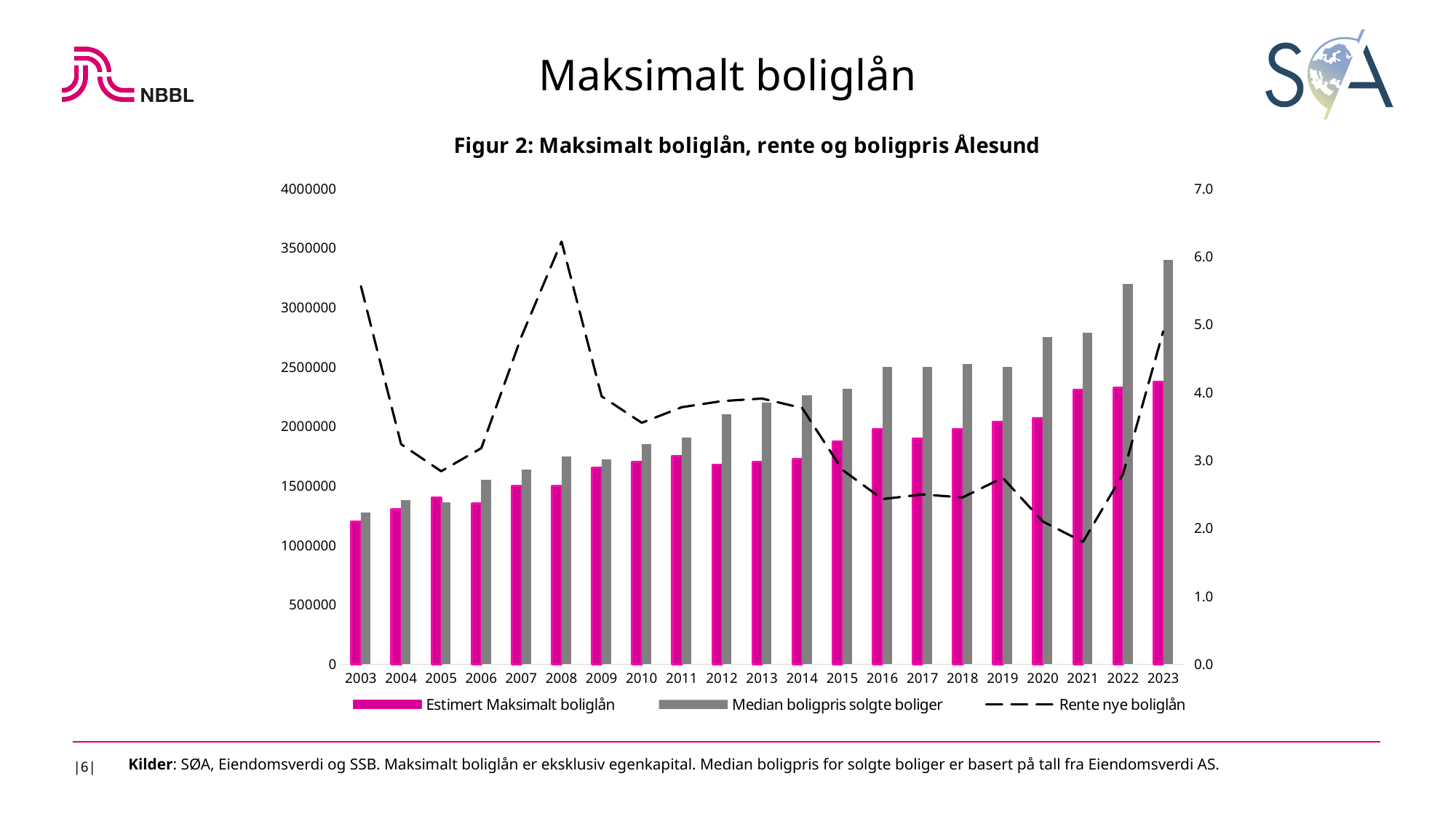
In which year is Rente nye boliglån highest? 2008 Is the value for Median boligpris solgte boliger in 2023 greater or less than 3000000? greater What kind of chart is shown in Figur 2? A bar chart combined with a dashed line In which year is Rente nye boliglån lowest? 2021 Does Median boligpris solgte boliger generally rise or fall from 2003 to 2023? rise In which year is Median boligpris solgte boliger lowest? 2003 In 2023, which is larger: Estimert Maksimalt boliglån or Median boligpris solgte boliger? Median boligpris solgte boliger Is the value for Estimert Maksimalt boliglån in 2023 greater or less than 2500000? less Is the value for Rente nye boliglån in 2003 greater or less than 5.0? greater How many series does the legend list? 3 How many years are shown on the x axis? 21 In which year is Median boligpris solgte boliger highest? 2023